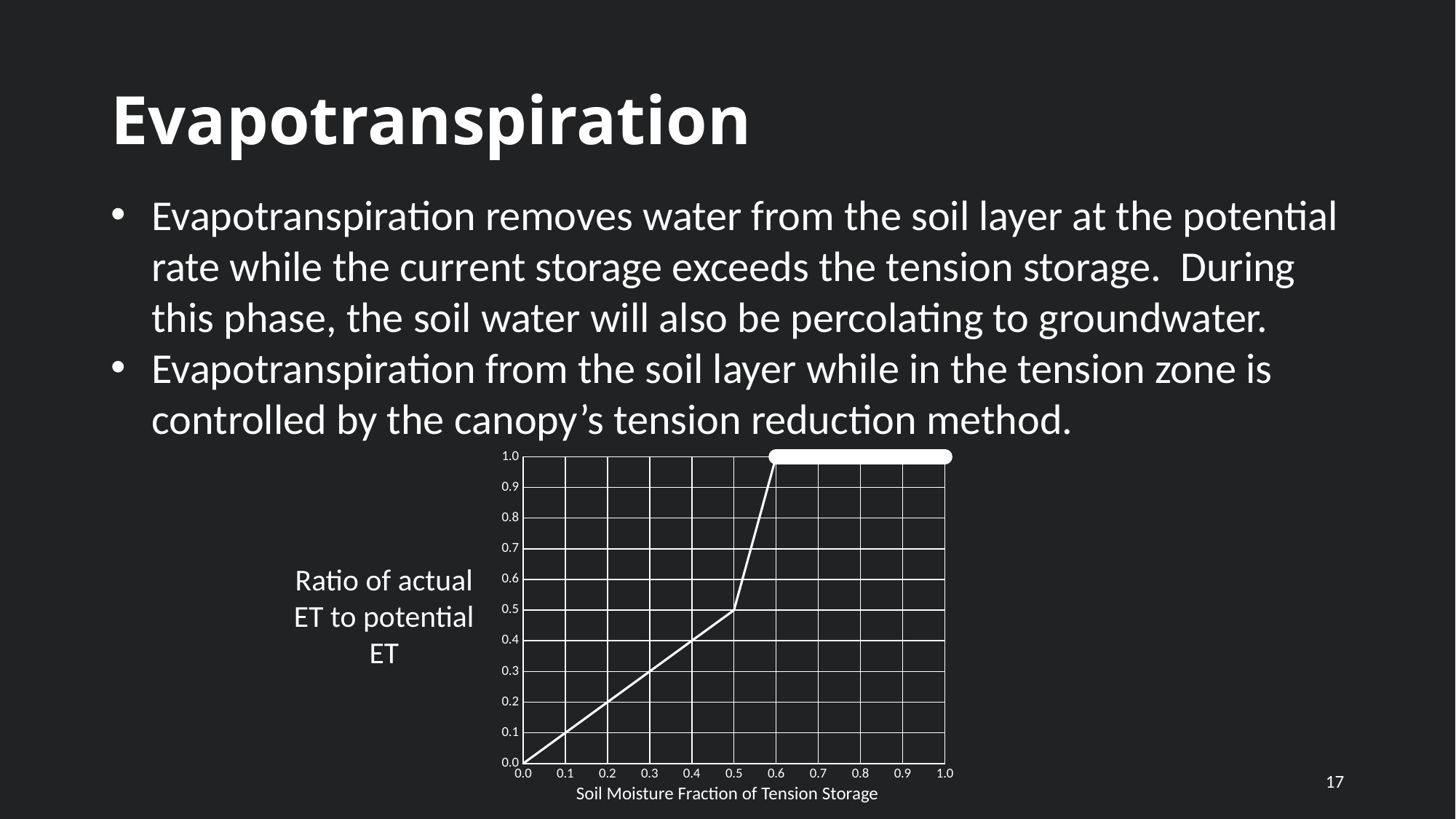
What is the ratio of actual ET to potential ET when the soil moisture fraction of tension storage is 0.6? 1.0 What kind of chart is shown on the slide? line chart Is the ratio of actual ET to potential ET at a soil moisture fraction of 0.8 greater or less than 0.9? greater Does the ratio of actual ET to potential ET rise or fall as the soil moisture fraction increases from 0.0 to 0.6? rise What is the ratio of actual ET to potential ET when the soil moisture fraction of tension storage is 0.5? 0.5 What is the ratio of actual ET to potential ET when the soil moisture fraction of tension storage is 1.0? 1.0 What is the maximum value shown on the y axis of the chart? 1.0 What is the x-axis title of the chart? Soil Moisture Fraction of Tension Storage What is the ratio of actual ET to potential ET when the soil moisture fraction of tension storage is 0.0? 0.0 What is the y-axis label of the chart? Ratio of actual ET to potential ET Which is larger: the ratio of actual ET to potential ET at a soil moisture fraction of 0.2 or at 0.7? 0.7 Is the ratio of actual ET to potential ET at a soil moisture fraction of 0.3 greater or less than 0.5? less